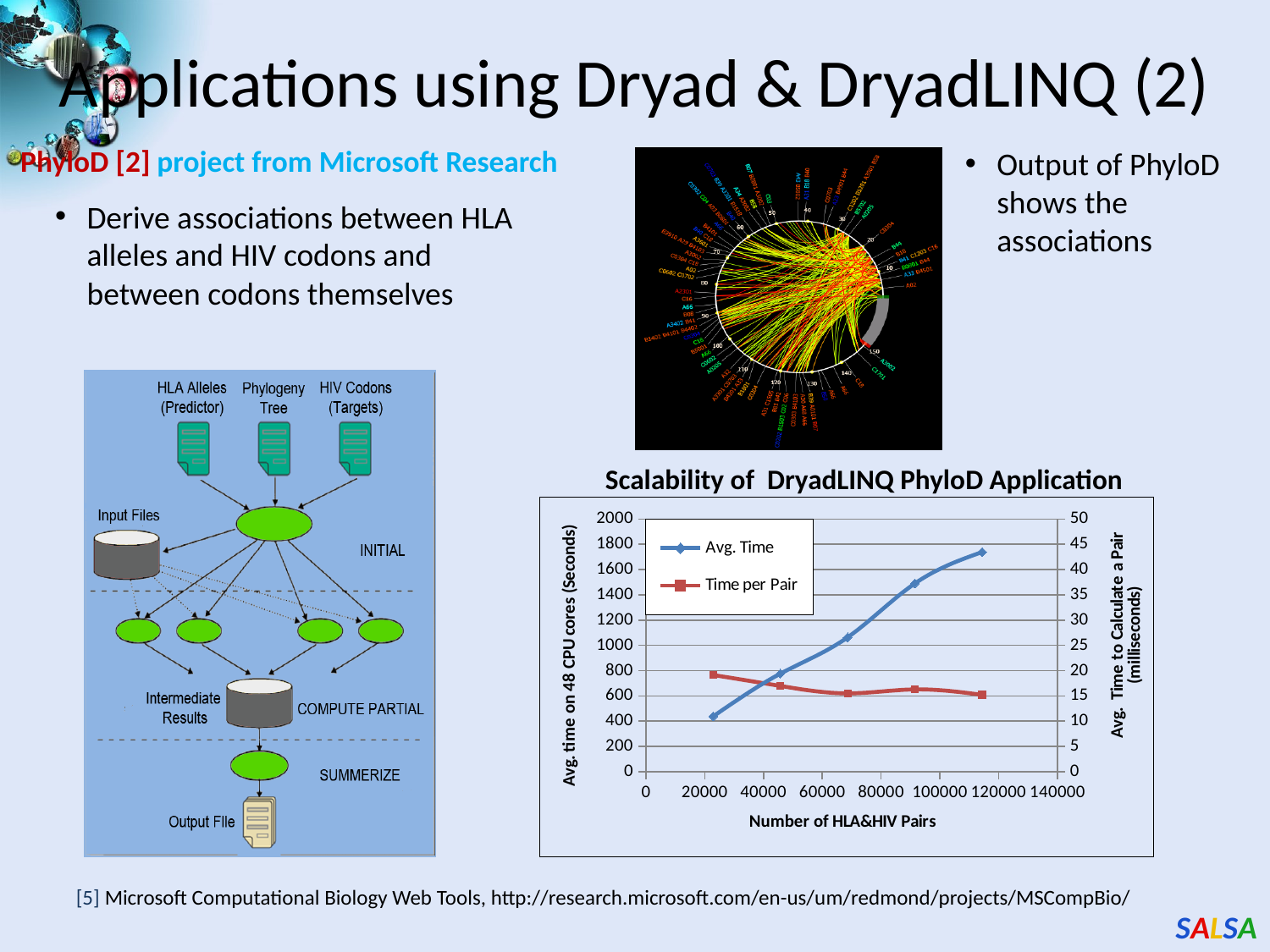
What kind of chart is 'Scalability of DryadLINQ PhyloD Application'? line chart In the 'Scalability of DryadLINQ PhyloD Application' chart, is the Avg. Time at around 40000 pairs greater or less than 1000 seconds? less In the 'Scalability of DryadLINQ PhyloD Application' chart, does Avg. Time rise or fall as the number of HLA&HIV pairs increases? rise In the 'Scalability of DryadLINQ PhyloD Application' chart, is the Avg. Time at the largest number of pairs greater or less than 1600 seconds? greater How many series does the legend of the 'Scalability of DryadLINQ PhyloD Application' chart list? 2 In the 'Scalability of DryadLINQ PhyloD Application' chart, does Time per Pair overall rise or fall as the number of HLA&HIV pairs increases? fall In the 'Scalability of DryadLINQ PhyloD Application' chart, is the Avg. Time at the smallest number of pairs greater or less than 600 seconds? less How many data points are plotted for the Avg. Time series in the 'Scalability of DryadLINQ PhyloD Application' chart? 5 What is the title of the x axis in the 'Scalability of DryadLINQ PhyloD Application' chart? Number of HLA&HIV Pairs What are the two series named in the legend of the 'Scalability of DryadLINQ PhyloD Application' chart? Avg. Time and Time per Pair In the 'Scalability of DryadLINQ PhyloD Application' chart, is the Avg. Time larger at the smallest or at the largest number of HLA&HIV pairs? largest